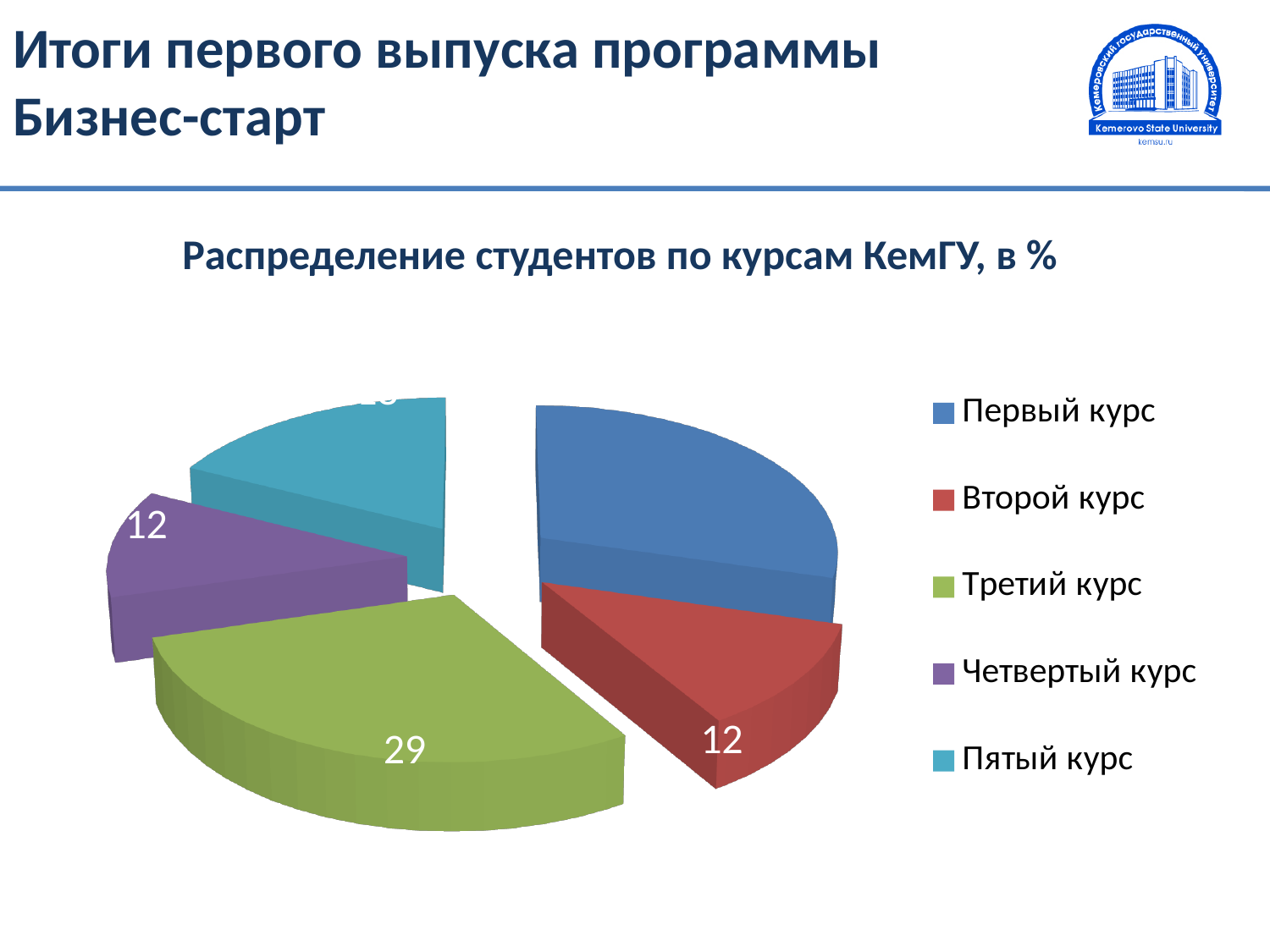
What is the value for Третий курс? 29 Which is larger, Третий курс or Пятый курс? Третий курс What kind of chart is shown on the slide? Pie chart What is the difference between the values for Третий курс and Второй курс? 17 What is the title of the chart? Распределение студентов по курсам КемГУ, в % What colour is the slice for Третий курс? Green What is the value for Второй курс? 12 How many categories does the legend list? 5 What is the value for Четвертый курс? 12 Which is larger, Третий курс or Второй курс? Третий курс